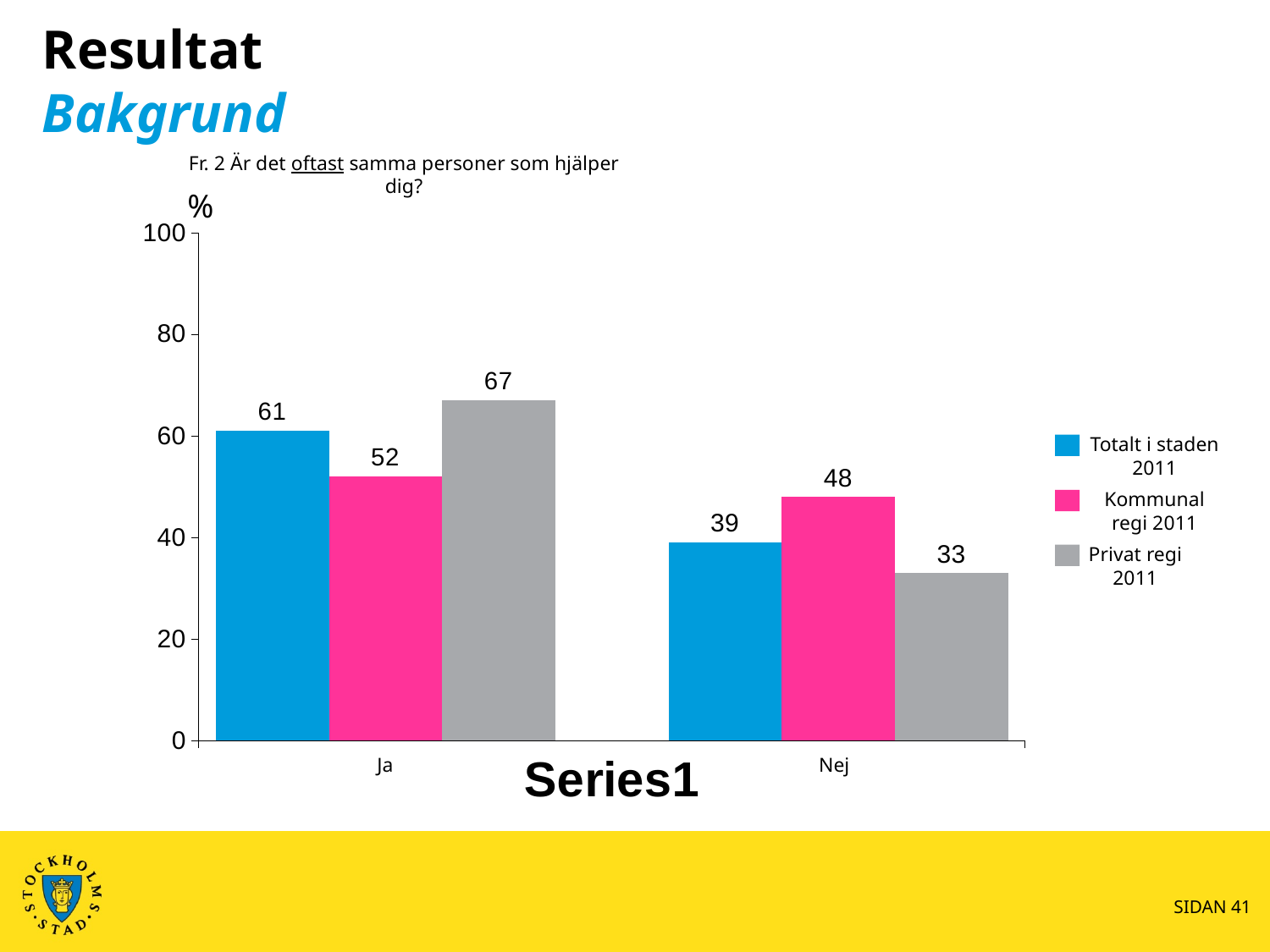
What is the value for Totalt i staden 2011 in the Ja category? 61 What colour represents Kommunal regi 2011 in the legend? Pink Which series has the highest value in the Ja category? Privat regi 2011 What is the difference between the Privat regi 2011 values for Ja and Nej? 34 What is the value for Privat regi 2011 in the Ja category? 67 What kind of chart is shown on the slide? Bar chart How many categories are shown on the x axis? 2 How many series does the legend list? 3 Which series has the lowest value in the Nej category? Privat regi 2011 What is the value for Kommunal regi 2011 in the Nej category? 48 Which is larger: Kommunal regi 2011 for Ja or Kommunal regi 2011 for Nej? Ja Is the value for Totalt i staden 2011 in the Nej category greater or less than 40? less